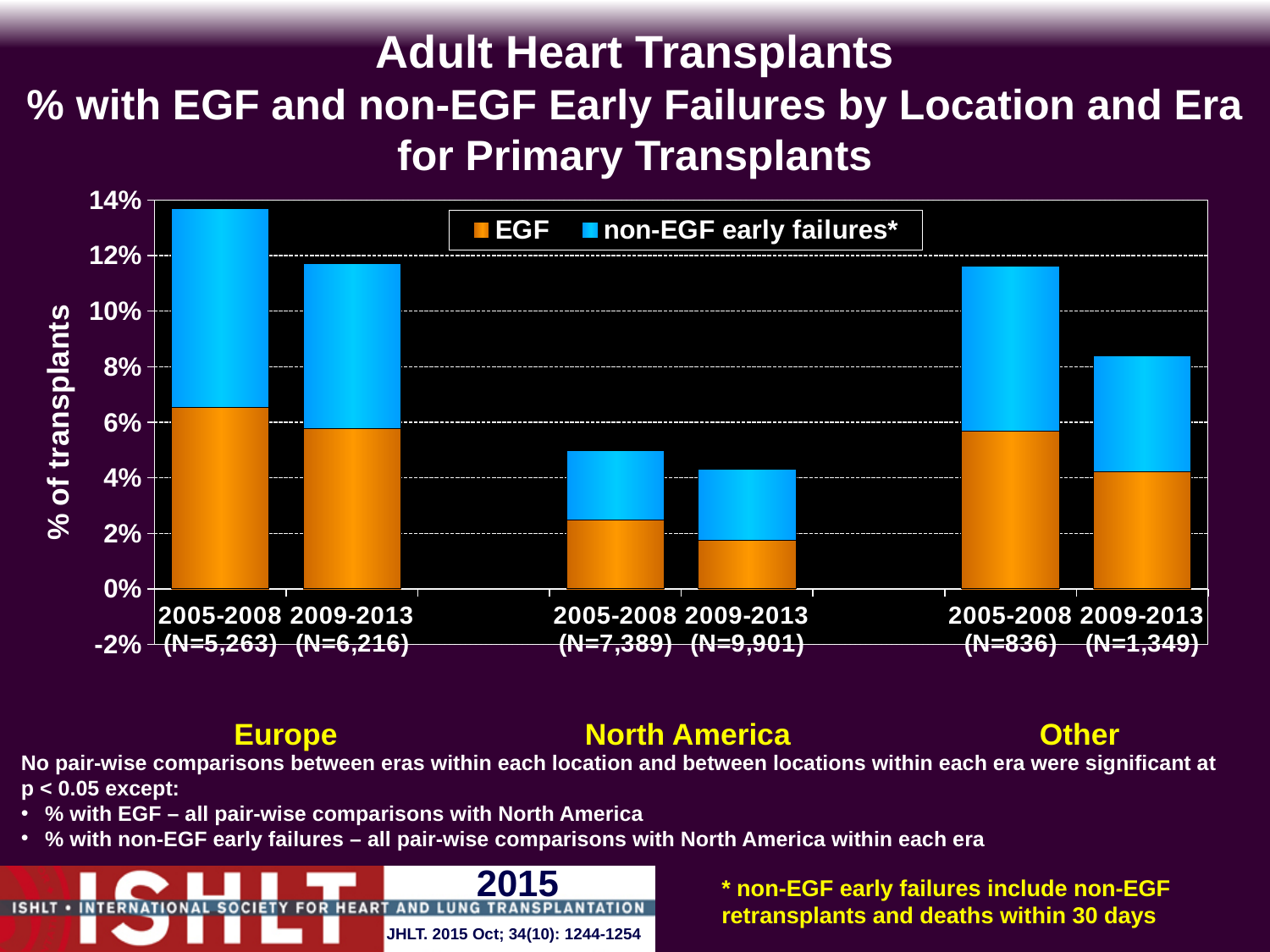
How many bars are plotted in the chart? 6 What are the two series named in the legend? EGF and non-EGF early failures* Which has the larger total percentage: Europe 2005-2008 or North America 2005-2008? Europe 2005-2008 Within each location, does the total percentage rise or fall from the 2005-2008 era to the 2009-2013 era? Fall Is the total value for North America 2009-2013 greater or less than 6%? less Is the total value for Europe 2005-2008 greater or less than 12%? greater What kind of chart is shown on the slide? Stacked bar chart Is the EGF value for Europe 2005-2008 greater or less than 4%? greater Which bar has the lowest total percentage of transplants? North America 2009-2013 (N=9,901) Which bar has the highest total percentage of transplants? Europe 2005-2008 (N=5,263) How many series does the legend list? 2